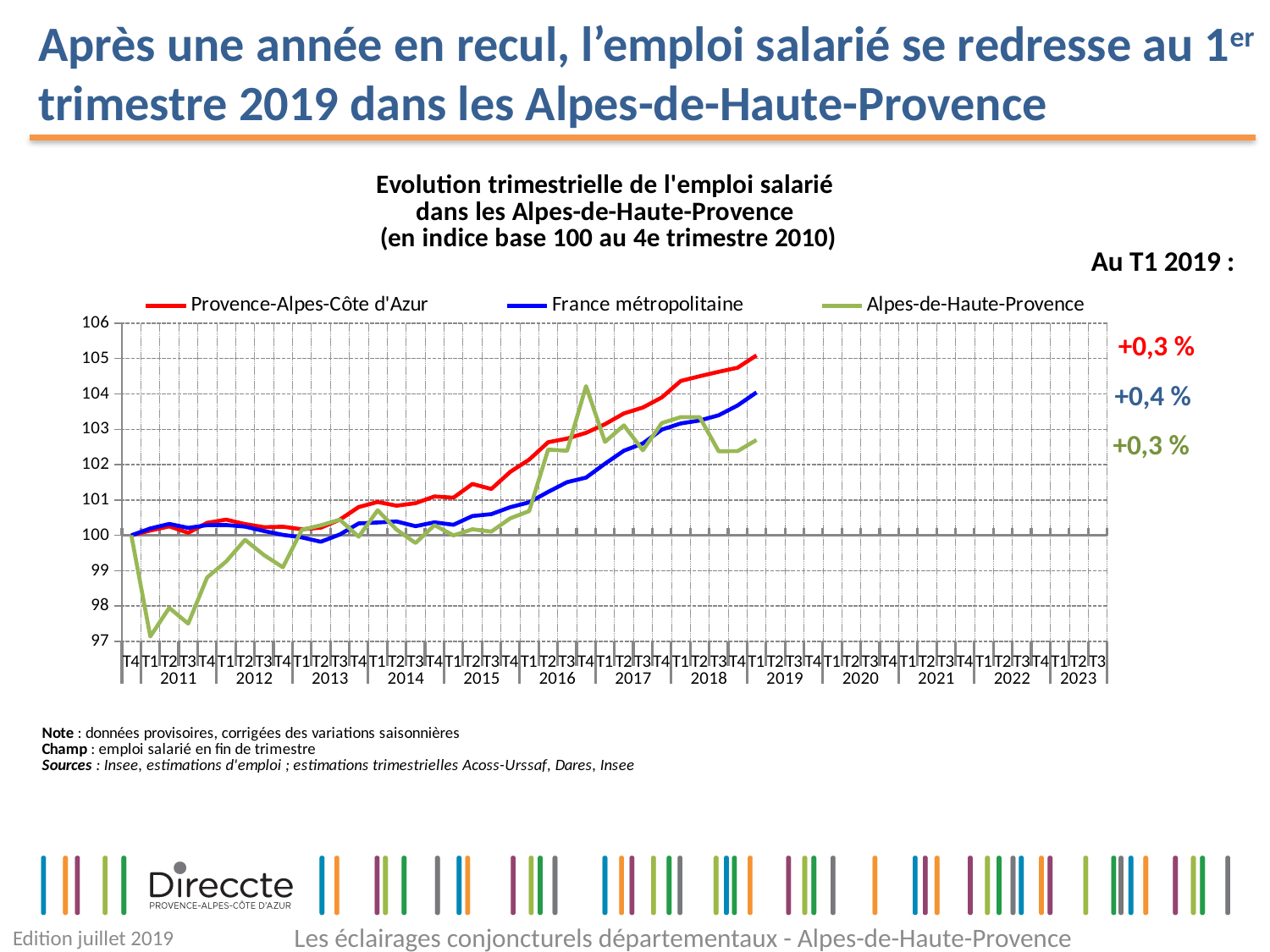
What quarterly change is annotated for France métropolitaine at T1 2019? +0,4 % Which series has the lowest index value at T1 2019? Alpes-de-Haute-Provence Which series is shown in red in the legend? Provence-Alpes-Côte d'Azur What quarterly change is annotated for Provence-Alpes-Côte d'Azur at T1 2019? +0,3 % How many series does the legend list? 3 Is the value for Alpes-de-Haute-Provence at T1 2011 greater or less than 98? less Does the France métropolitaine line rise or fall between 2015 and T1 2019? rise Which series has the highest index value at T1 2019? Provence-Alpes-Côte d'Azur Is the value for Provence-Alpes-Côte d'Azur at T1 2019 greater or less than 104? greater At T1 2019, which is higher: Provence-Alpes-Côte d'Azur or France métropolitaine? Provence-Alpes-Côte d'Azur What is the index value of all three series at T4 2010, the base quarter? 100 What kind of chart is shown on the slide? line chart